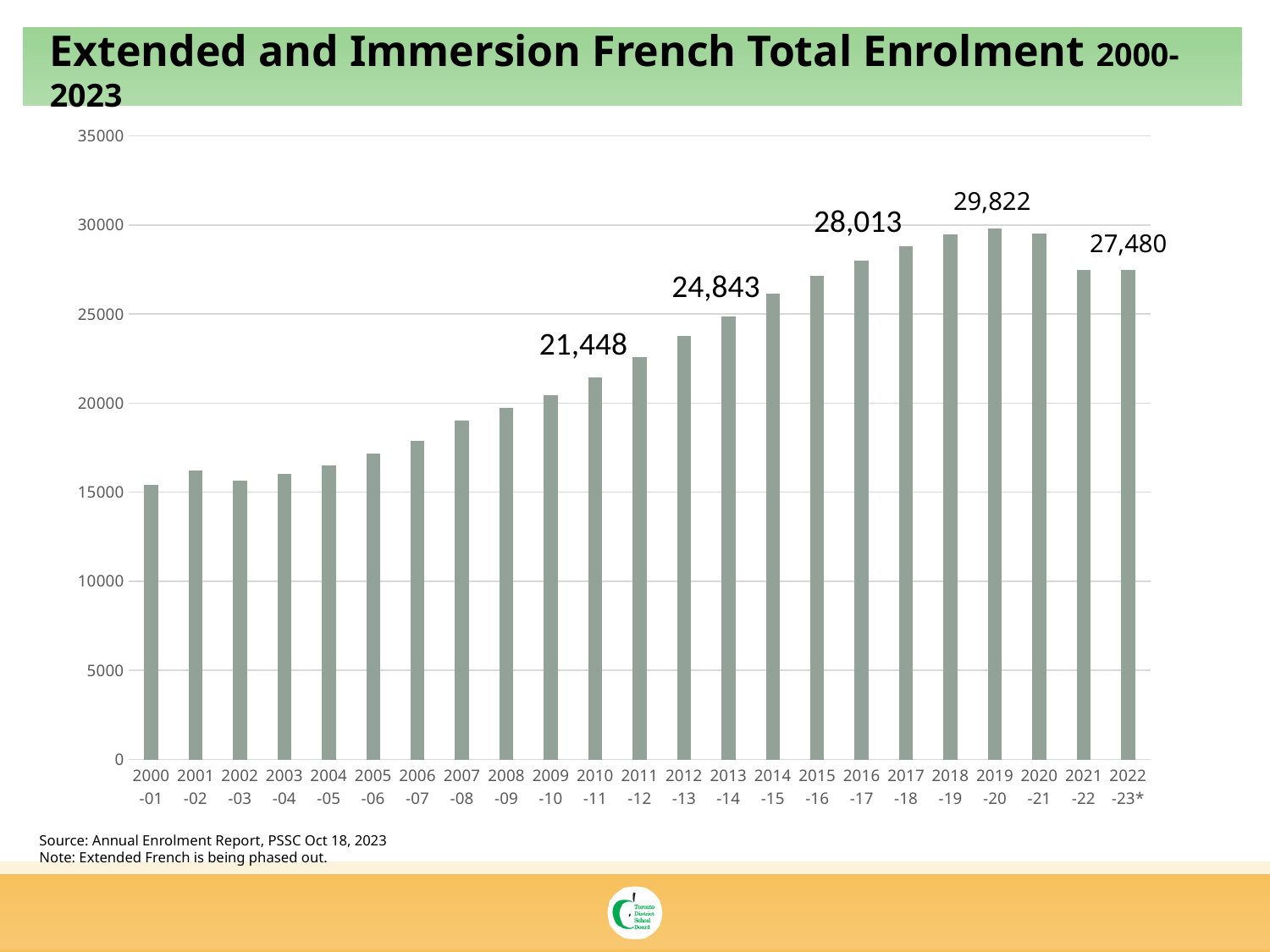
What type of chart is shown on the slide? bar chart How many school years are shown on the x axis? 23 What is the total enrolment for 2022-23*? 27,480 Which is larger, the enrolment for 2016-17 or for 2022-23*? 2016-17 Is the enrolment for 2000-01 greater or less than 20000? less What is the difference in enrolment between 2019-20 and 2022-23*? 2,342 Which school year has the highest total enrolment? 2019-20 What is the total enrolment for 2019-20? 29,822 What is the total enrolment for 2016-17? 28,013 What is the difference in enrolment between 2016-17 and 2013-14? 3,170 What is the total enrolment for 2013-14? 24,843 What is the total enrolment for 2010-11? 21,448